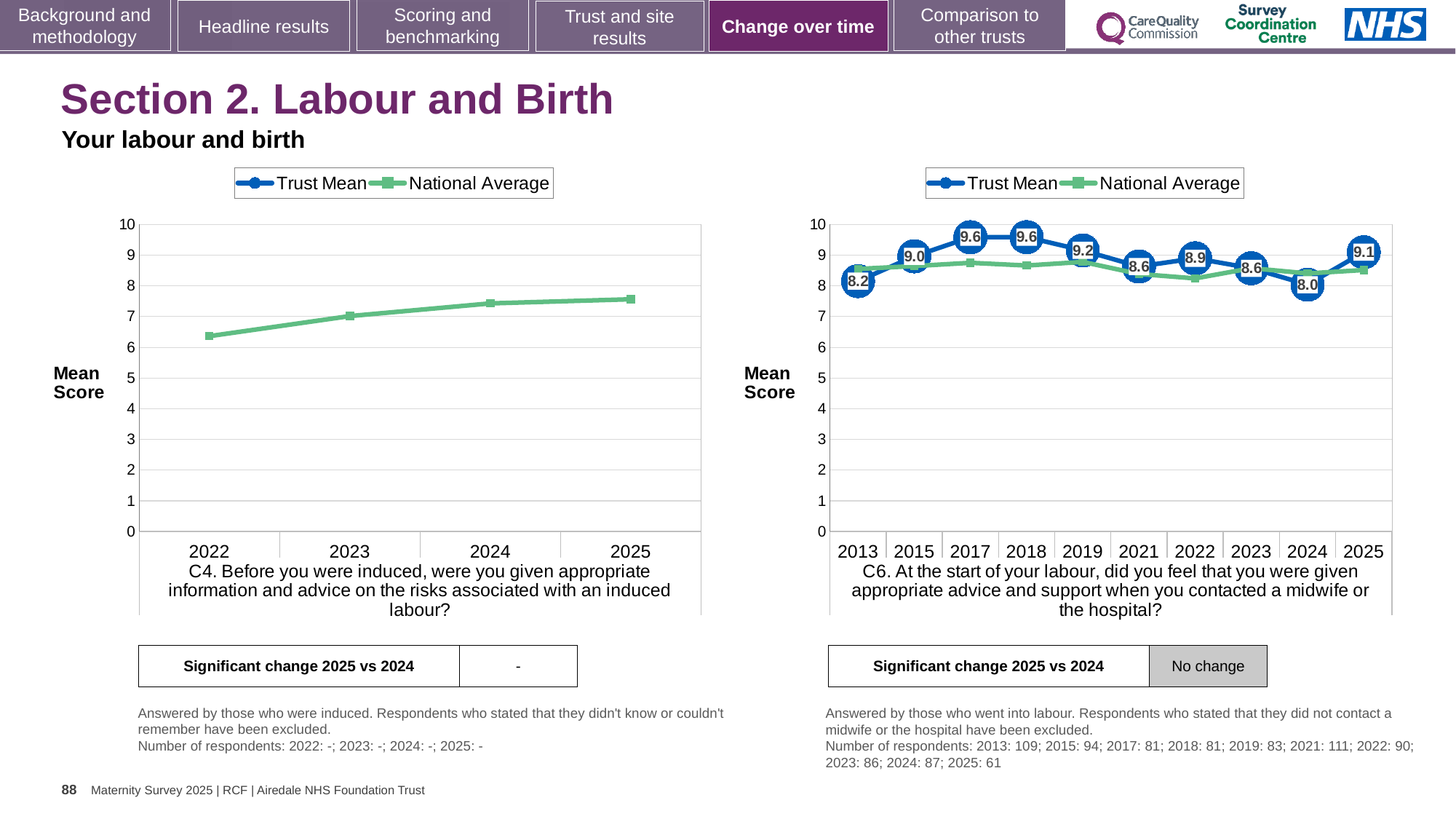
In the C6 chart on the right, is the Trust Mean higher in 2019 or in 2021? 2019 In the C6 chart on the right, how many years are shown on the x axis? 10 In the C4 chart on the left, does the National Average rise or fall from 2022 to 2025? rise In the C6 chart on the right, what is the Trust Mean for 2013? 8.2 What type of chart is the C4 chart on the left? line chart How many series does the legend of the C6 chart on the right list? 2 In the C6 chart on the right, what is the difference between the Trust Mean in 2025 and in 2024? 1.1 In the C4 chart on the left, is the National Average for 2022 greater or less than 7? less In the C4 chart on the left, is the National Average for 2025 greater or less than 7? greater In the C6 chart on the right, what is the Trust Mean for 2025? 9.1 In the C6 chart on the right, which year has the lowest Trust Mean? 2024 In the C6 chart on the right, what is the Trust Mean for 2024? 8.0